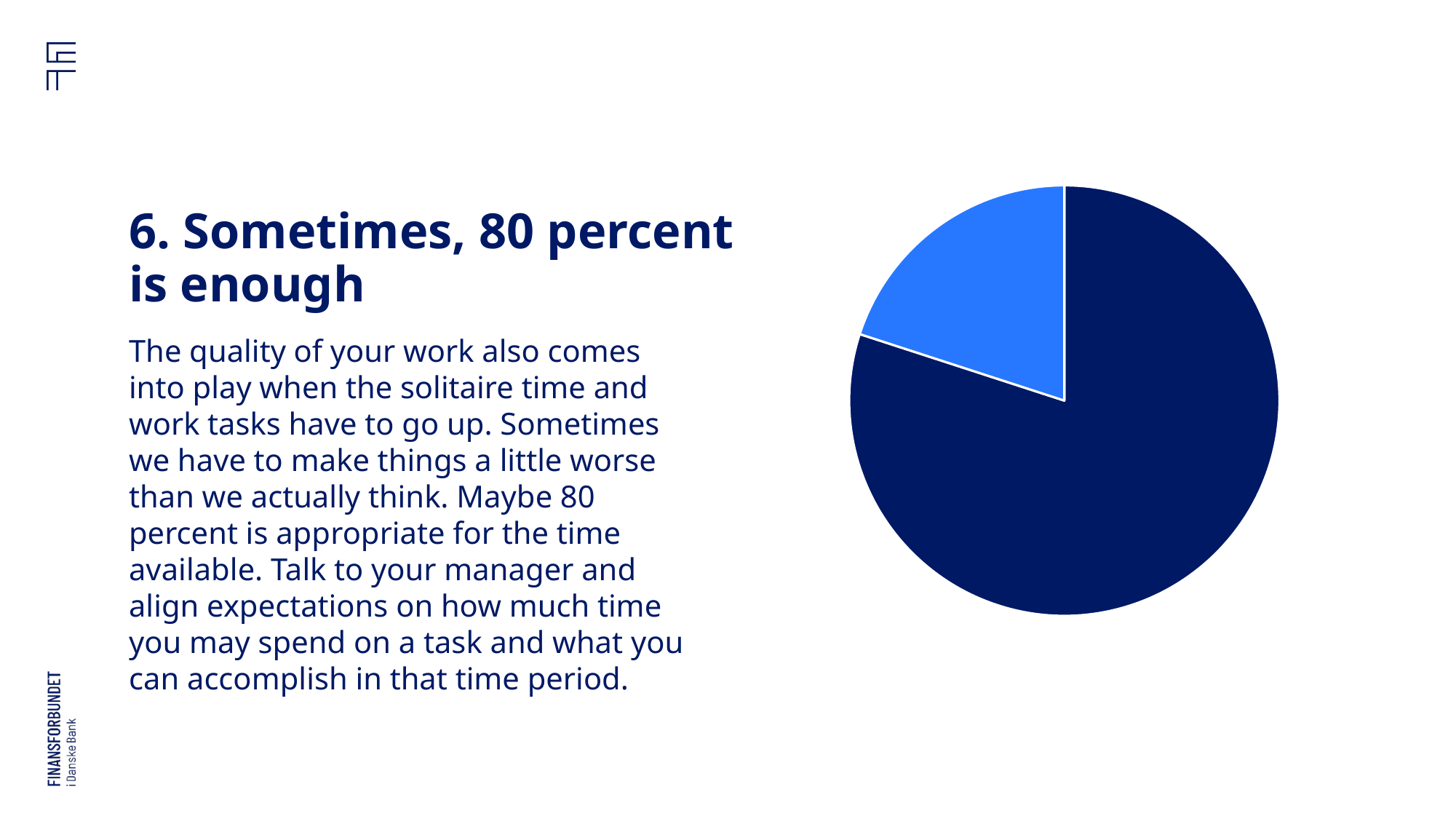
Which slice of the pie chart is larger, the dark blue one or the light blue one? dark blue How many slices does the pie chart have? 2 What two colours are used for the slices of the pie chart? dark blue and light blue Which slice of the pie chart is the largest? the dark blue slice Does the pie chart have a legend? No What kind of chart is shown on the slide? pie chart Which slice of the pie chart is the smallest? the light blue slice